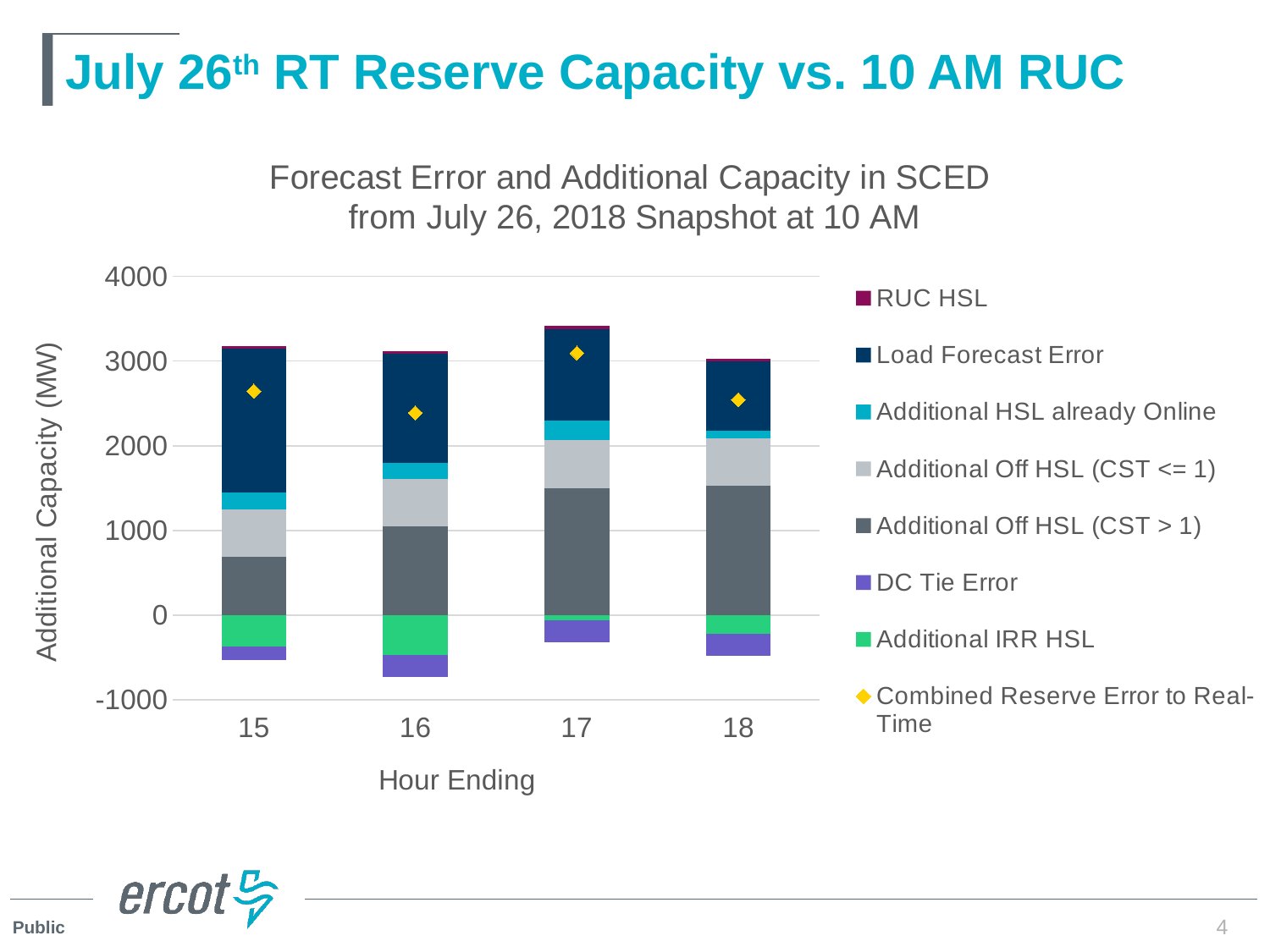
What kind of chart is shown on the slide? Stacked bar chart How many hour-ending categories are shown on the x axis? 4 Which hour ending has the bar extending furthest below zero? 16 What is the label of the y axis? Additional Capacity (MW) What is the title of the chart? Forecast Error and Additional Capacity in SCED from July 26, 2018 Snapshot at 10 AM How many series does the legend list? 8 Which hour ending has the highest Combined Reserve Error to Real-Time marker? 17 Is the Combined Reserve Error to Real-Time value for hour ending 15 greater or less than 2000? greater Is the Combined Reserve Error to Real-Time value for hour ending 16 greater or less than 3000? less Is the Combined Reserve Error to Real-Time value for hour ending 17 greater or less than 3000? greater Which hour ending has the tallest positive stacked bar? 17 Which hour ending has the smallest Additional Off HSL (CST > 1) segment? 15